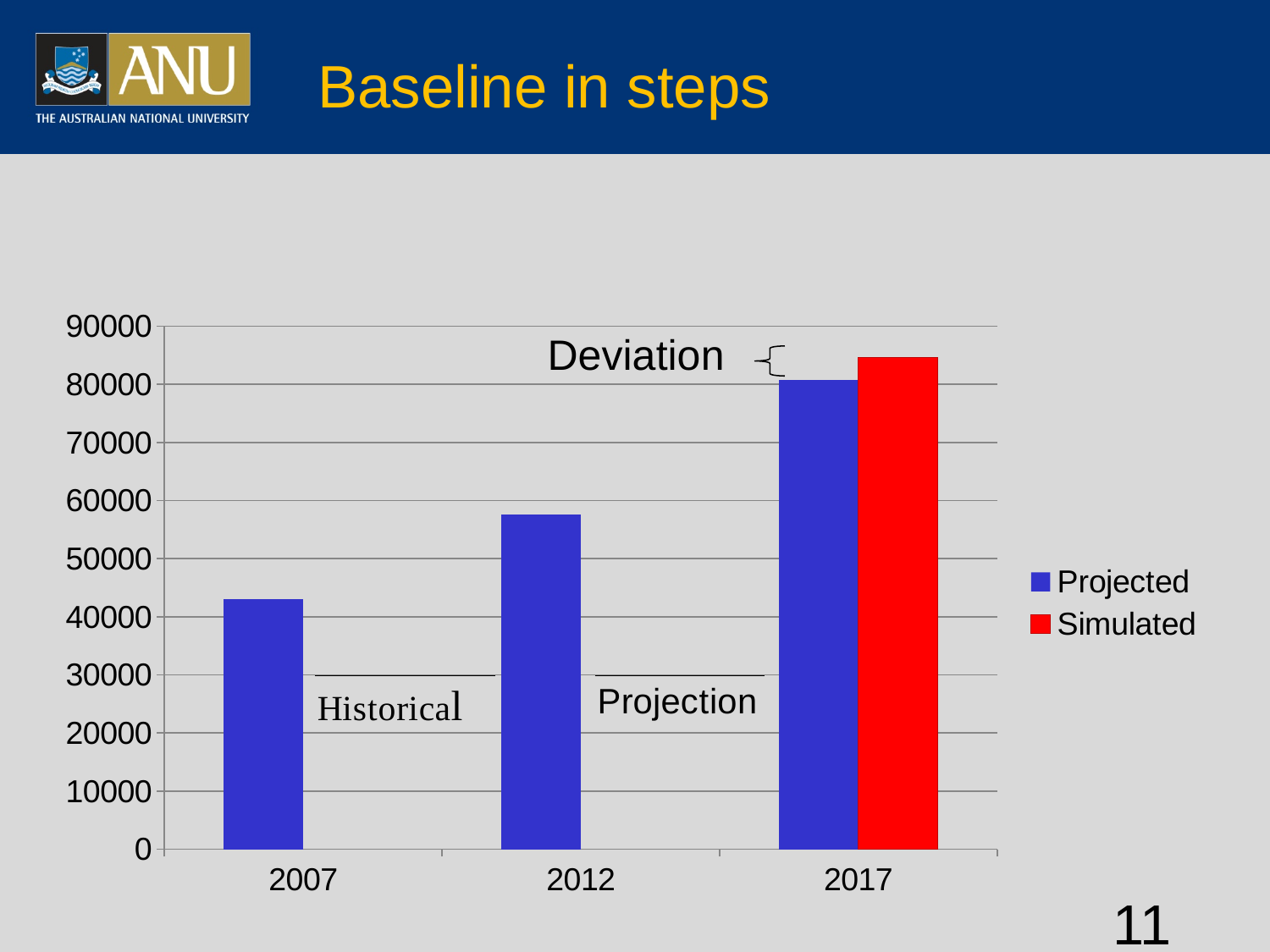
Is the Projected value for 2012 greater or less than 60000? less Which series is shown in red? Simulated Which year has the highest Projected value? 2017 How many series does the legend list? 2 Do the Projected values rise or fall from 2007 to 2017? rise Is the Projected value for 2007 greater or less than 40000? greater Which year has the lowest Projected value? 2007 What kind of chart is shown on the slide? bar chart Is the Simulated value for 2017 greater or less than 80000? greater How many years are shown on the x axis? 3 For 2017, which is larger, the Projected or the Simulated value? Simulated What label is placed between the 2007 and 2012 bars? Historical